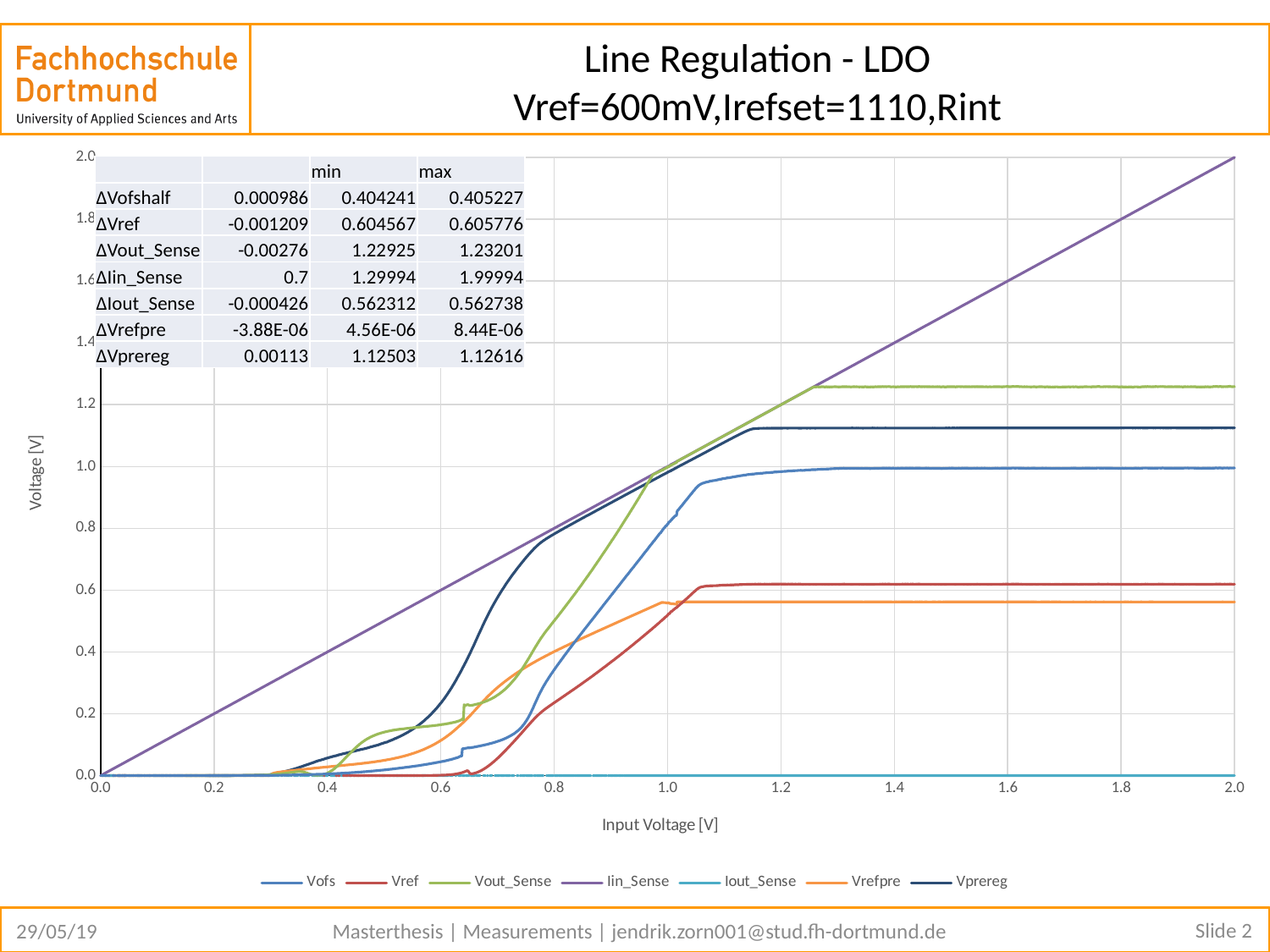
At an input voltage of 2.0 V, is the value of Vrefpre greater or less than 0.6? less What kind of chart is shown on the slide? line chart What is the label of the x axis of the chart? Input Voltage [V] Which series has the highest value at an input voltage of 2.0 V? Iin_Sense Does the Iin_Sense series rise or fall as the input voltage increases from 0.0 to 2.0? rise How many series does the chart legend list? 7 At an input voltage of 2.0 V, is the value of Vout_Sense greater or less than 1.2? greater In the table on the chart, what is the max value listed for ΔVout_Sense? 1.23201 In the table on the chart, what is the max value listed for ΔVprereg? 1.12616 In the table on the chart, what is the min value listed for ΔIin_Sense? 1.29994 What is the title of the chart on the slide? Line Regulation - LDO Vref=600mV,Irefset=1110,Rint At an input voltage of 2.0 V, which is larger, Vout_Sense or Vprereg? Vout_Sense